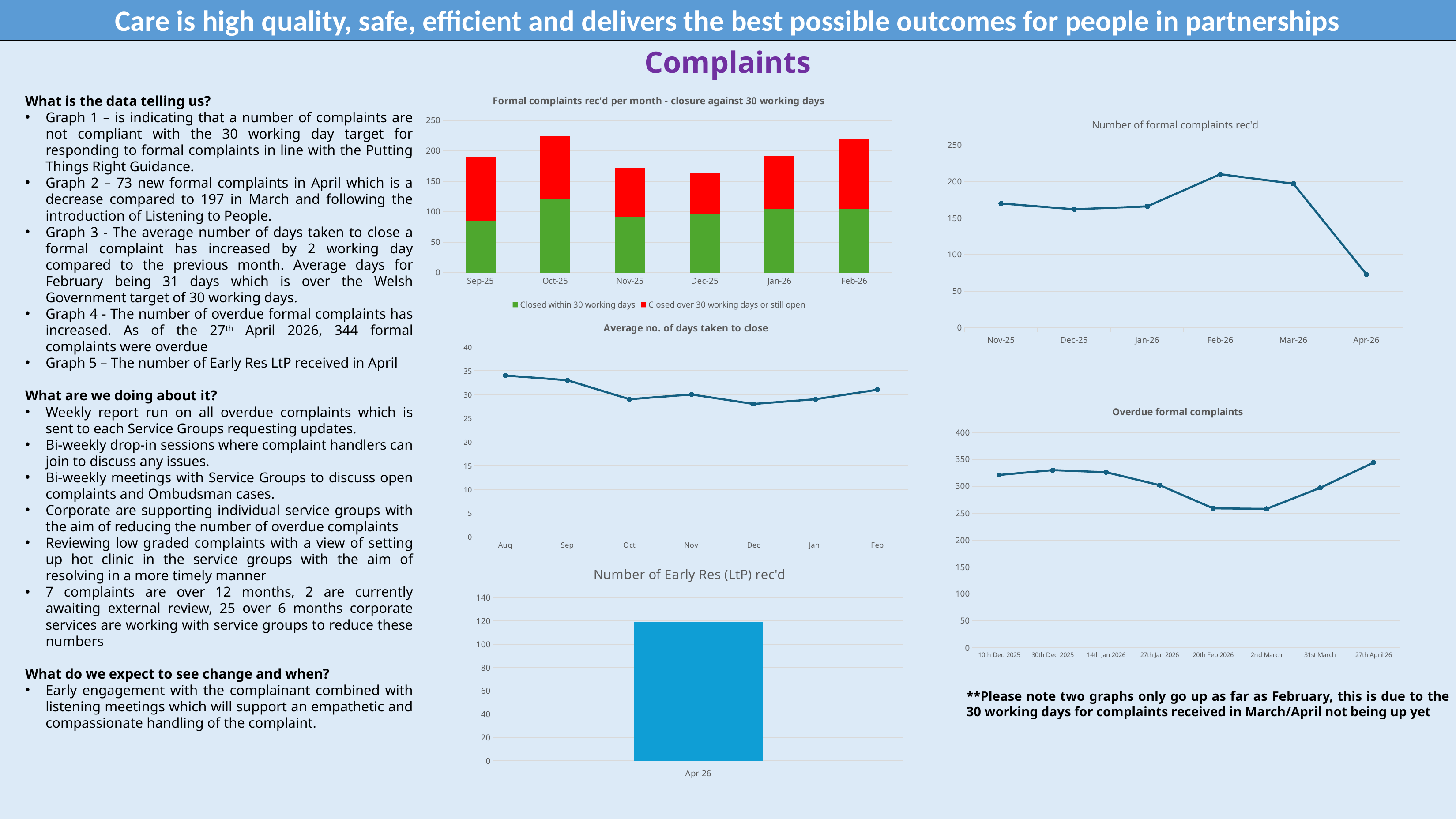
In 'Overdue formal complaints', is the value for 20th Feb 2026 greater or less than 300? less How many months are shown on the x axis of 'Average no. of days taken to close'? 7 In 'Number of Early Res (LtP) rec'd', is the value for Apr-26 greater or less than 100? greater In 'Formal complaints rec'd per month - closure against 30 working days', which month has the lowest value for 'Closed within 30 working days'? Sep-25 What kind of chart is 'Formal complaints rec'd per month - closure against 30 working days'? Stacked bar chart How many series does the legend of 'Formal complaints rec'd per month - closure against 30 working days' list? 2 In 'Number of formal complaints rec'd', is the value for Feb-26 greater or less than 200? greater In 'Average no. of days taken to close', which month has the highest value? Aug In 'Number of formal complaints rec'd', which month has the lowest value? Apr-26 In 'Overdue formal complaints', which date has the highest value? 27th April 26 In 'Formal complaints rec'd per month - closure against 30 working days', which month has the highest value for 'Closed within 30 working days'? Oct-25